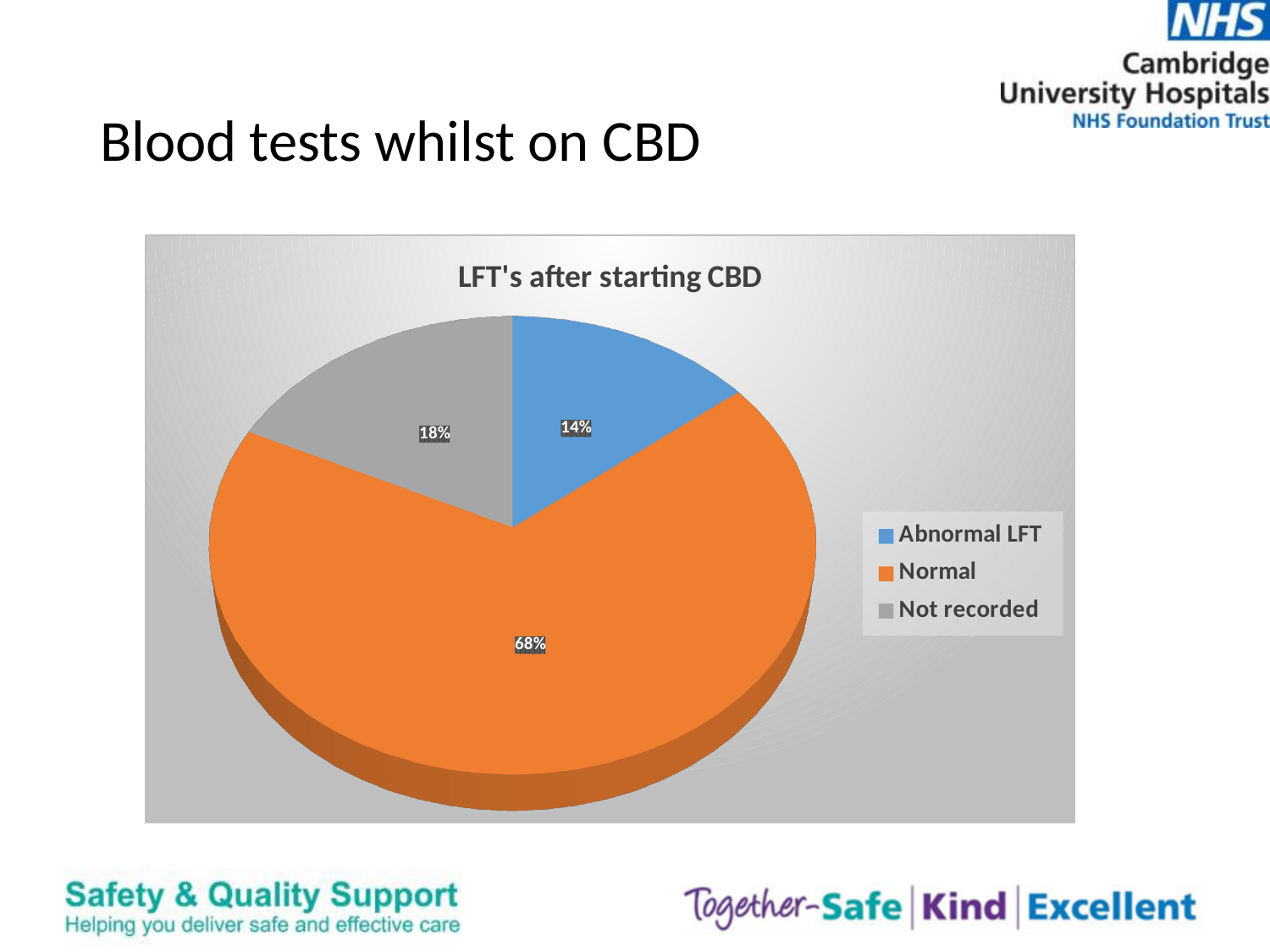
Which category has the largest share of the pie? Normal What is the difference in percentage points between the Not recorded and Abnormal LFT slices? 4 What is the difference in percentage points between the Normal and Not recorded slices? 50 What percentage of the pie is labelled Normal? 68% Which category has the smallest share of the pie? Abnormal LFT What colour is the Normal slice? Orange What percentage of the pie is labelled Abnormal LFT? 14% How many categories does the legend list? 3 What is the title of the chart? LFT's after starting CBD Which is larger, the Not recorded slice or the Abnormal LFT slice? Not recorded What kind of chart is shown on the slide? Pie chart What percentage of the pie is labelled Not recorded? 18%